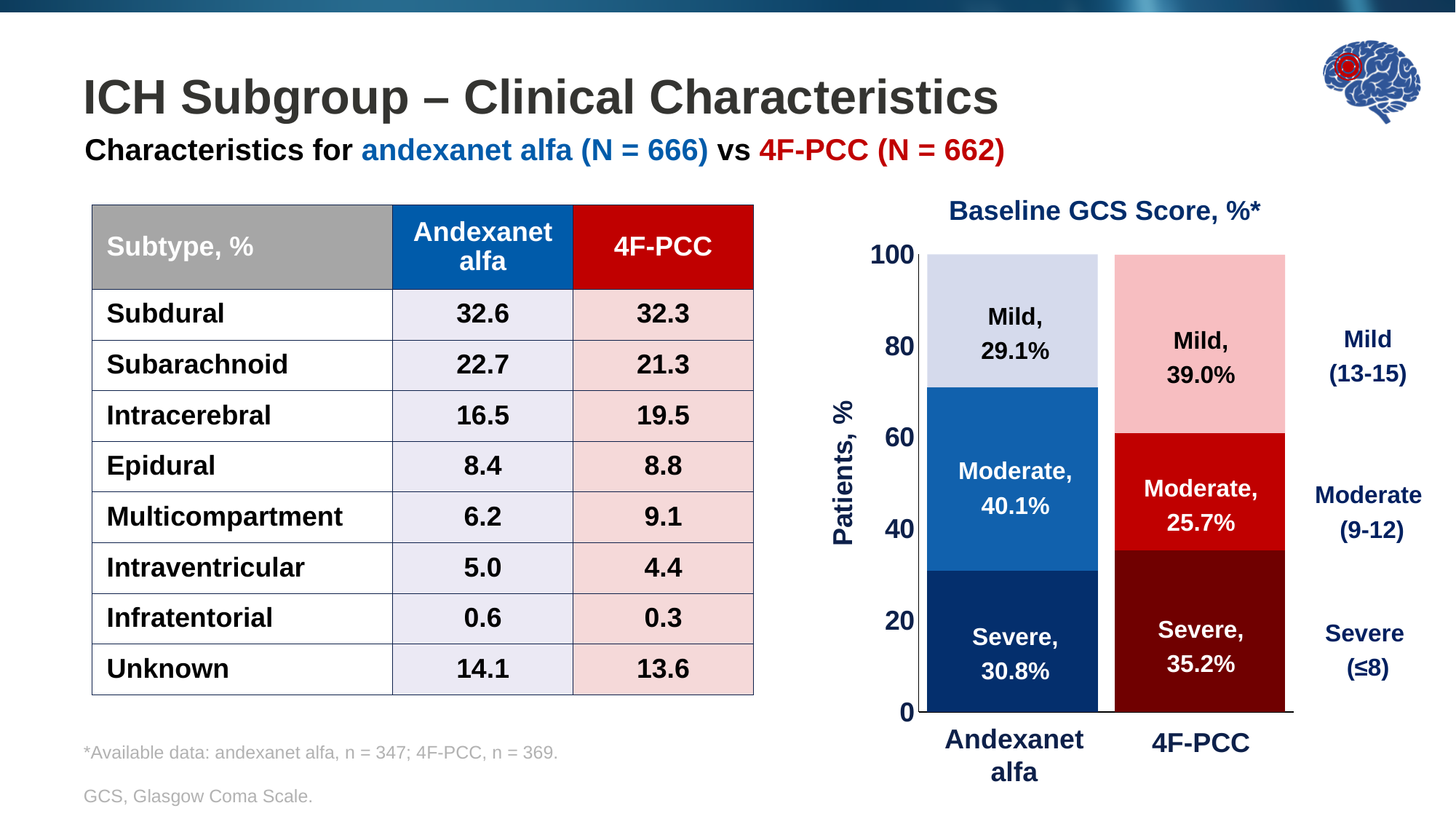
What kind of chart is shown on the slide? Stacked bar chart What is the label of the y-axis in the Baseline GCS Score chart? Patients, % In the Baseline GCS Score chart, which GCS category has the smallest share for 4F-PCC? Moderate In the Baseline GCS Score chart, what percentage of 4F-PCC patients had a Mild score? 39.0% In the Baseline GCS Score chart, what percentage of andexanet alfa patients had a Mild score? 29.1% In the Baseline GCS Score chart, what percentage of andexanet alfa patients had a Severe score? 30.8% What is the title of the chart on the slide? Baseline GCS Score, %* How many bars are plotted in the Baseline GCS Score chart? 2 In the Baseline GCS Score chart, which group has the higher Severe percentage, andexanet alfa or 4F-PCC? 4F-PCC In the Baseline GCS Score chart, what is the difference between the Moderate percentages for andexanet alfa and 4F-PCC? 14.4 percentage points In the Baseline GCS Score chart, which GCS category has the largest share for andexanet alfa? Moderate In the Baseline GCS Score chart, what percentage of 4F-PCC patients had a Moderate score? 25.7%